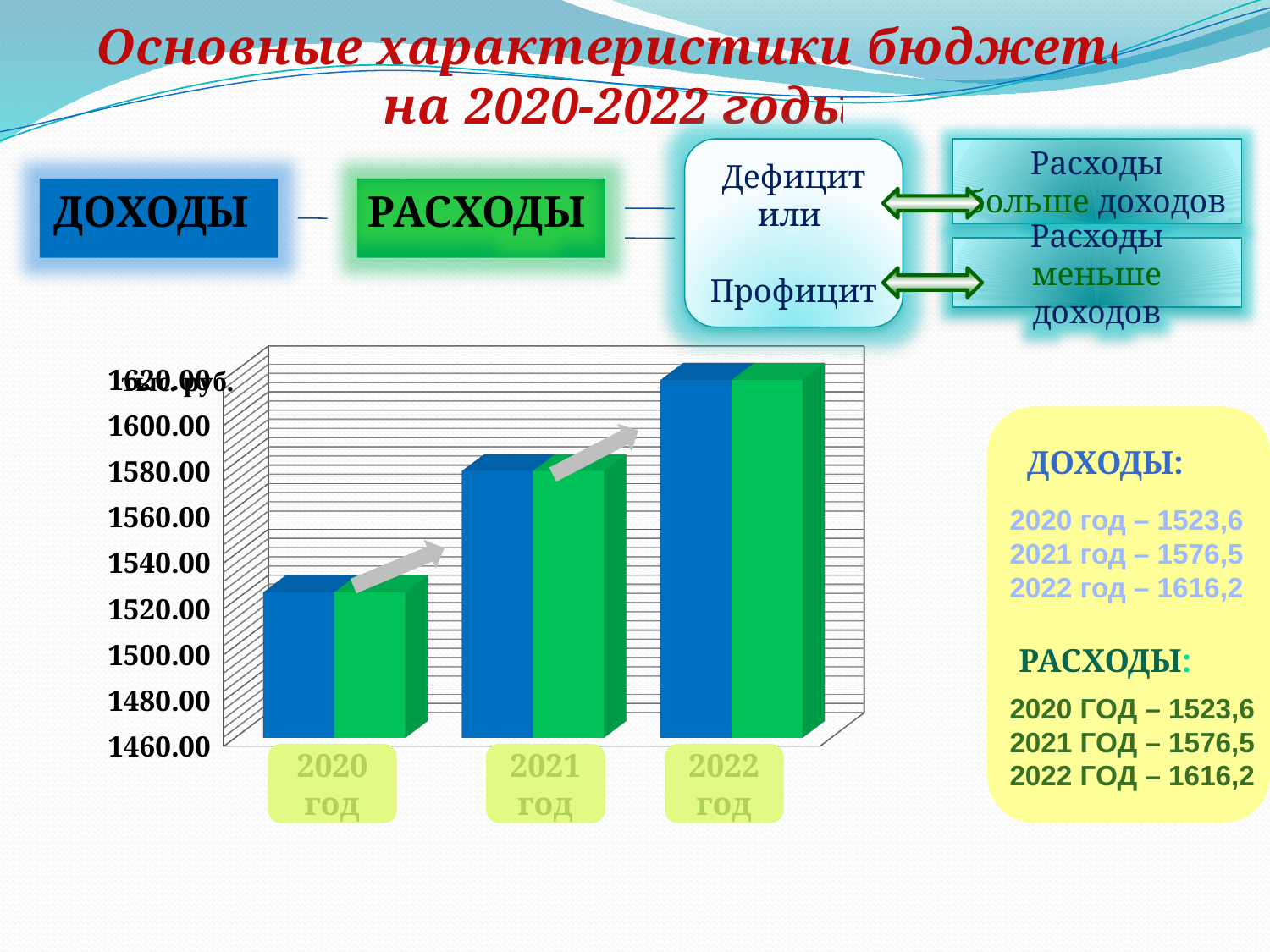
Is the value for 2022 год greater or less than 1600.00? greater Using the ДОХОДЫ figures printed on the slide, what is the difference between 2022 год and 2020 год? 92,6 Is the value for 2020 год greater or less than 1500.00? greater Is the value for 2021 год greater or less than 1600.00? less How many year categories are shown on the x axis of the chart? 3 How many bars are plotted for each year in the chart? 2 What kind of chart is shown on the slide? bar chart Which year has the highest bars in the chart? 2022 год What unit is written at the top of the chart's vertical axis? тыс. руб. According to the ДОХОДЫ figures printed on the slide, what is the value for 2021 год? 1576,5 Do the bar values rise or fall from 2020 год to 2022 год? rise Which year has the lowest bars in the chart? 2020 год